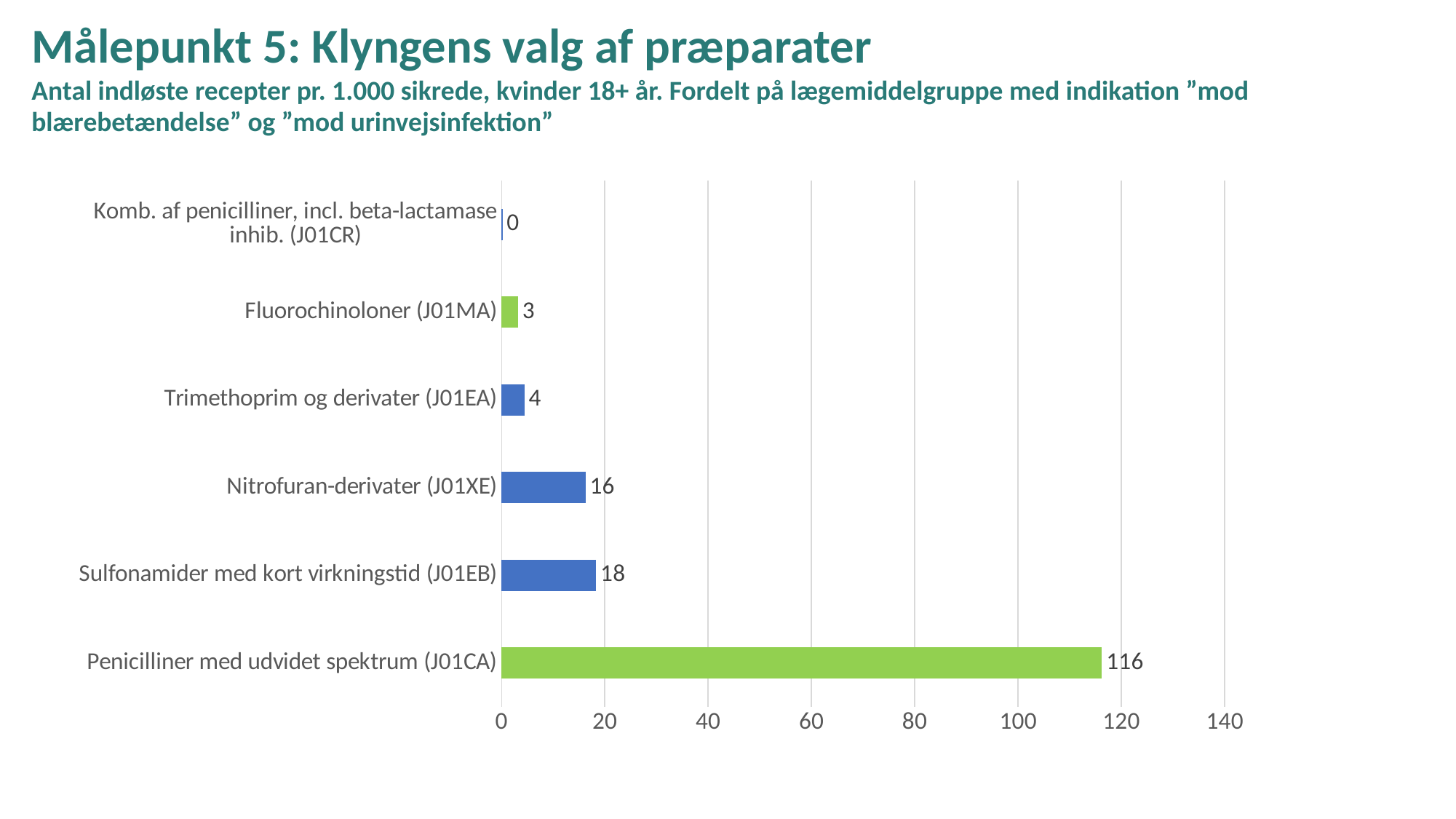
What is the value for Penicilliner med udvidet spektrum (J01CA)? 116 What is the value for Fluorochinoloner (J01MA)? 3 How many categories are shown in the chart? 6 What kind of chart is shown on the slide? Bar chart What is the value for Nitrofuran-derivater (J01XE)? 16 Is the value for Penicilliner med udvidet spektrum (J01CA) greater or less than 100? greater Which category has the lowest value? Komb. af penicilliner, incl. beta-lactamase inhib. (J01CR) What is the difference between the values for Penicilliner med udvidet spektrum (J01CA) and Sulfonamider med kort virkningstid (J01EB)? 98 Which category has the highest value? Penicilliner med udvidet spektrum (J01CA) What is the value for Sulfonamider med kort virkningstid (J01EB)? 18 Which is larger, the value for Trimethoprim og derivater (J01EA) or the value for Fluorochinoloner (J01MA)? Trimethoprim og derivater (J01EA) What is the difference between the values for Sulfonamider med kort virkningstid (J01EB) and Nitrofuran-derivater (J01XE)? 2